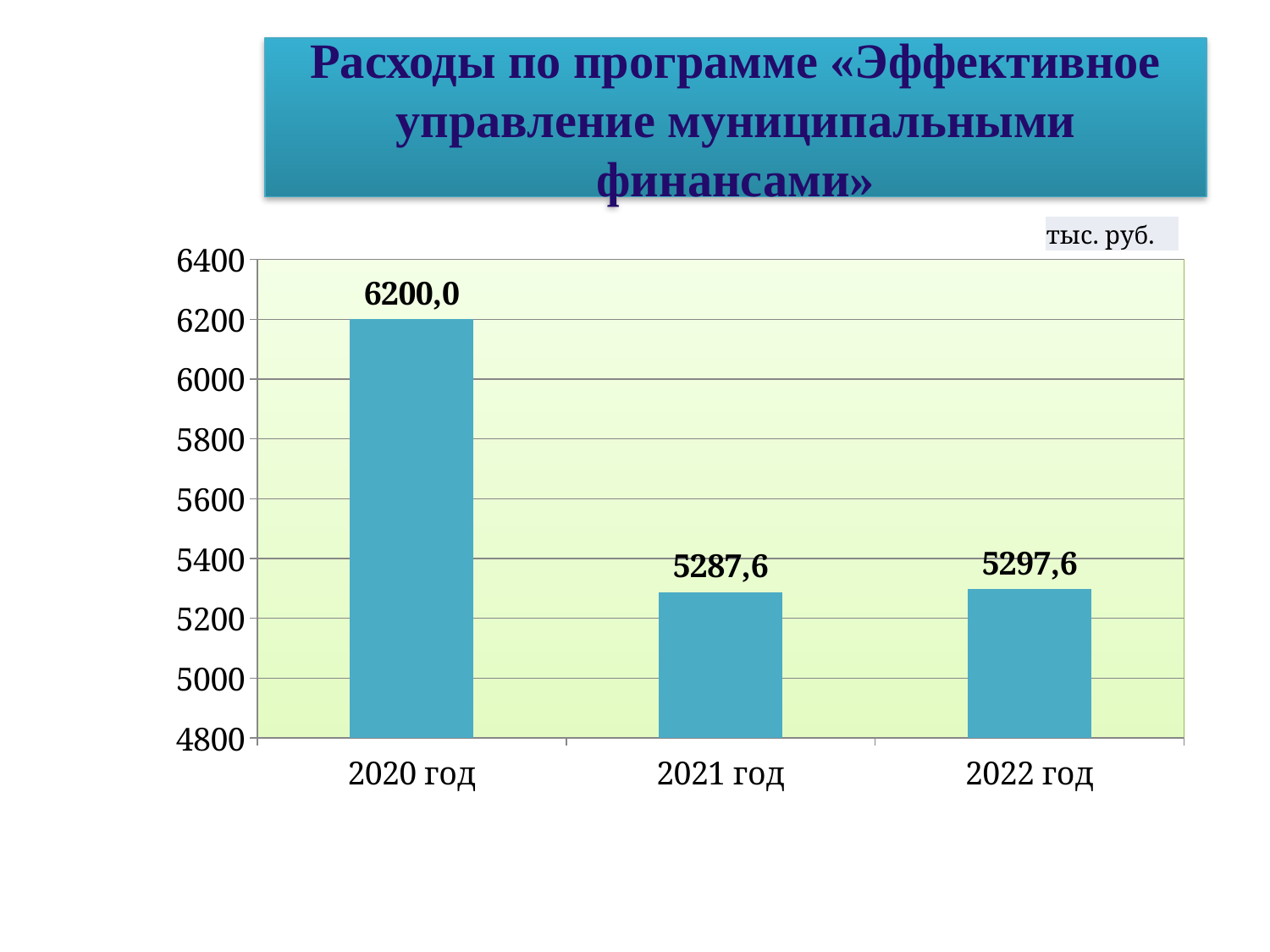
What is the difference between the values for 2020 год and 2021 год? 912,4 What kind of chart is shown on the slide? bar chart Which year has the lowest value? 2021 год Which is larger, the value for 2020 год or the value for 2022 год? 2020 год What is the value for 2021 год? 5287,6 What is the difference between the values for 2022 год and 2021 год? 10,0 Is the value for 2021 год greater or less than 5400? less How many years are shown on the x axis? 3 What is the value for 2022 год? 5297,6 What unit is indicated for the values on the chart? тыс. руб. What is the value for 2020 год? 6200,0 Which year has the highest value? 2020 год